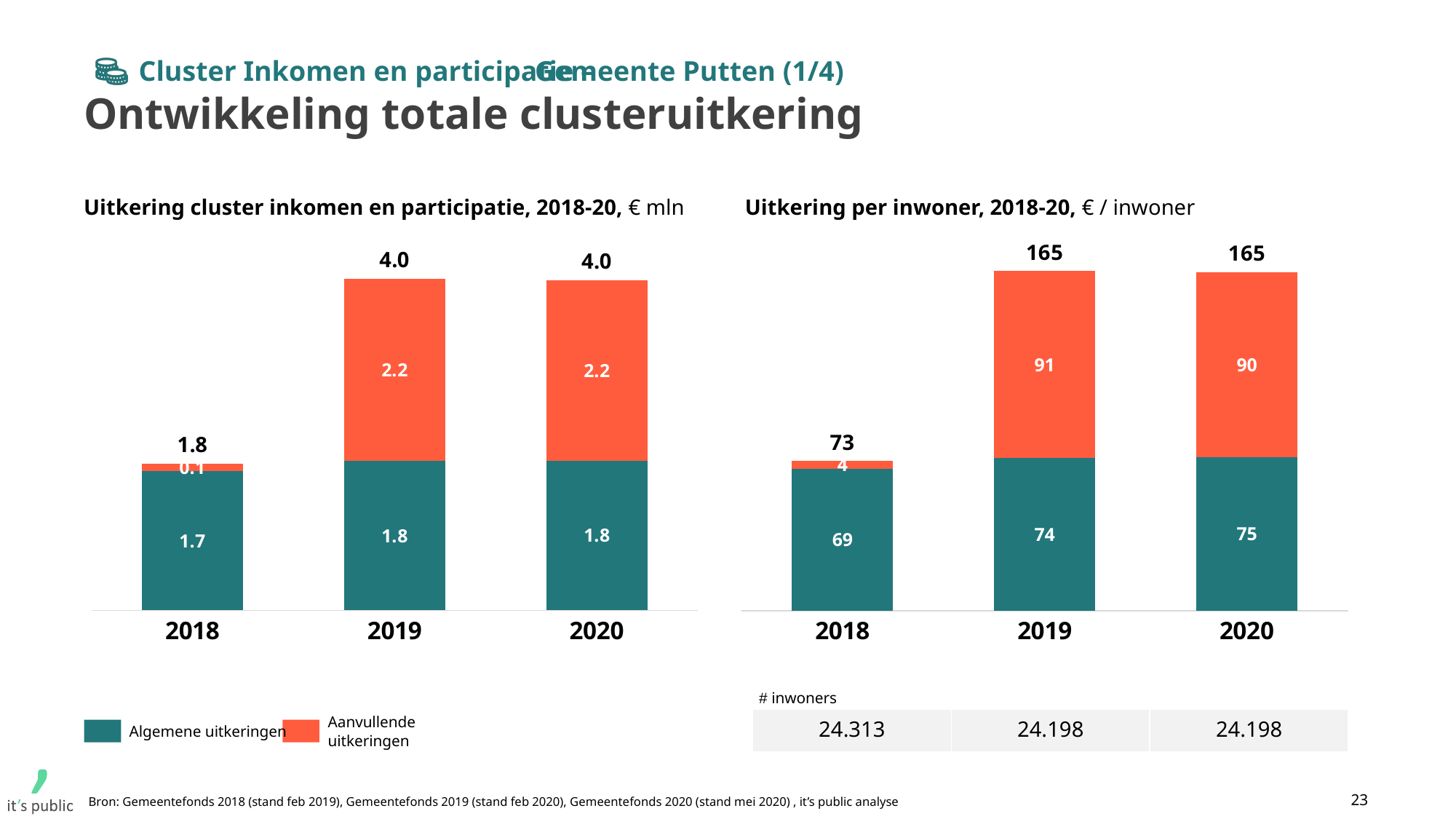
Which series is shown in orange in the legend? Aanvullende uitkeringen In the right chart (Uitkering per inwoner), what is the value of Aanvullende uitkeringen for 2020? 90 In the right chart (Uitkering per inwoner), what is the value of Algemene uitkeringen for 2018? 69 In the left chart (Uitkering cluster inkomen en participatie), what is the value of Aanvullende uitkeringen for 2019? 2.2 In the right chart (Uitkering per inwoner), what is the total of the stacked bar for 2019? 165 What kind of chart is the left chart (Uitkering cluster inkomen en participatie)? Stacked bar chart In the left chart (Uitkering cluster inkomen en participatie), which year has the lowest total? 2018 In the right chart (Uitkering per inwoner), is the Algemene uitkeringen value larger in 2020 or in 2018? 2020 In the right chart (Uitkering per inwoner), what is the difference between the Aanvullende uitkeringen values for 2019 and 2020? 1 In the left chart (Uitkering cluster inkomen en participatie), what is the value of Algemene uitkeringen for 2018? 1.7 In the left chart (Uitkering cluster inkomen en participatie), what is the total of the stacked bar for 2020? 4.0 How many series does the legend list? 2